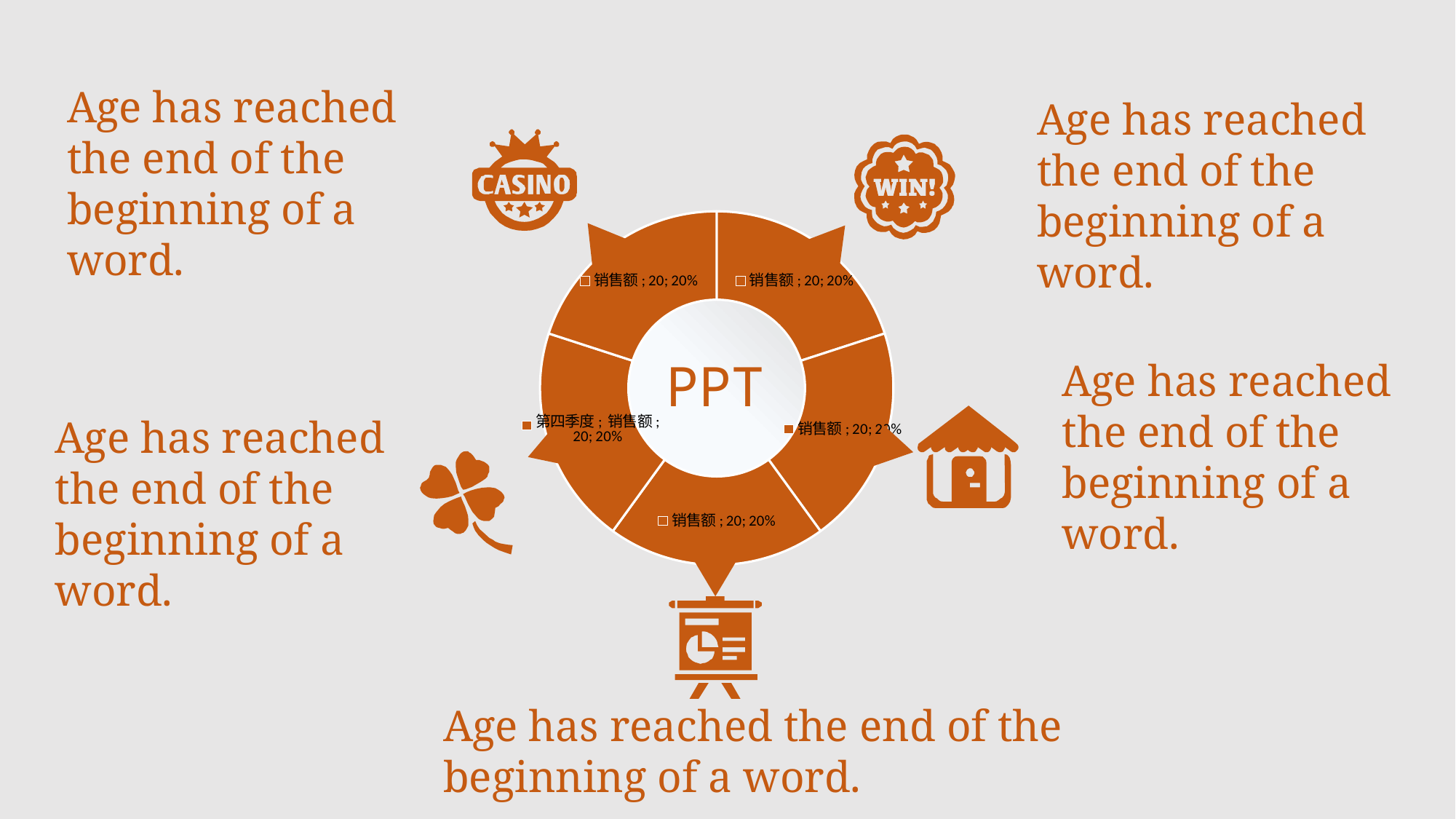
What is the 销售额 value shown for 第四季度? 20 What kind of chart is shown on the slide? doughnut (pie) chart Is the value for 第四季度 greater or less than 10? greater What percentage is shown on each slice of the chart? 20% What is the name of the data series shown in the chart labels? 销售额 What text appears in the centre of the chart? PPT What is the total of all the slice values shown on the chart? 100 How many slices does the chart have? 5 Are all the slices of the chart the same size? Yes What share of the chart does the 第四季度 slice represent? 20%